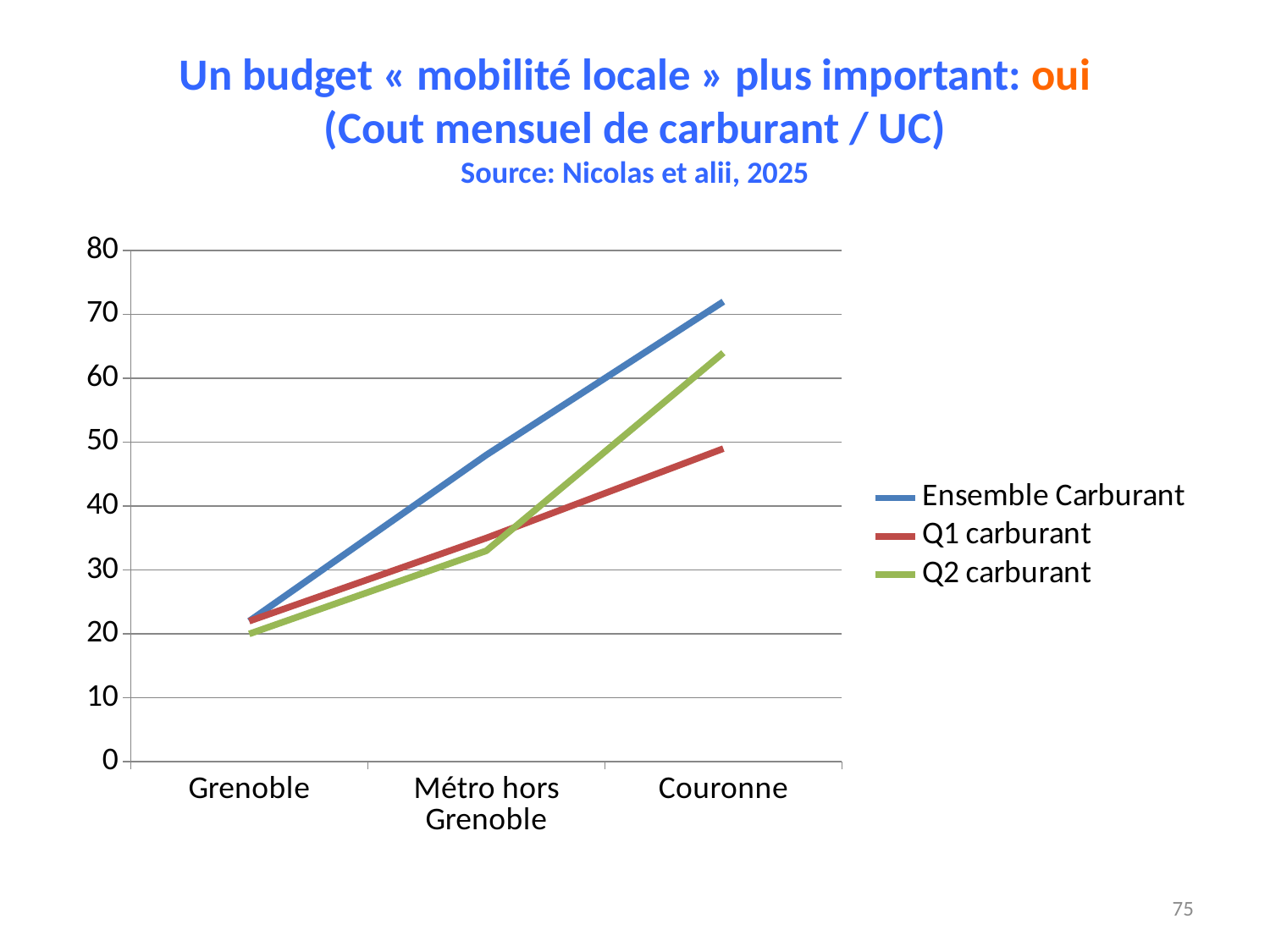
Is the value for Ensemble Carburant at Métro hors Grenoble greater or less than 40? greater What colour is the line for Q1 carburant? red How many series does the legend list? 3 Which series has the lowest value at Couronne? Q1 carburant What kind of chart is shown on the slide? line chart Do the values for Ensemble Carburant rise or fall from Grenoble to Couronne? rise Is the value for Q2 carburant at Grenoble greater or less than 30? less At Couronne, which is larger: Q2 carburant or Q1 carburant? Q2 carburant How many categories are shown on the x axis? 3 Which series has the highest value at Couronne? Ensemble Carburant Is the value for Ensemble Carburant at Couronne greater or less than 70? greater